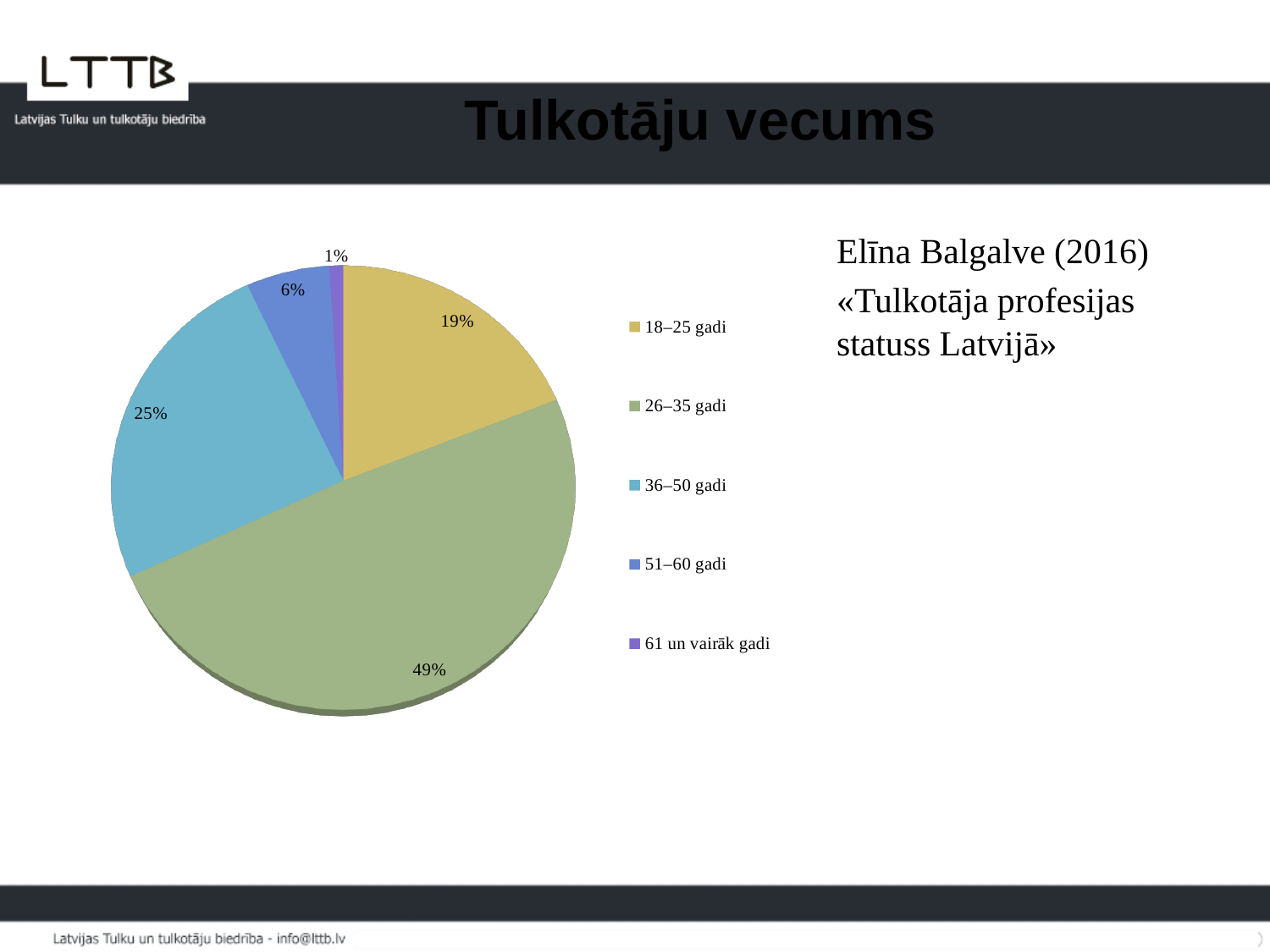
Which age group has the largest slice of the pie? 26–35 gadi What is the title of the slide containing the pie chart? Tulkotāju vecums Which is larger, the share for 18–25 gadi or the share for 36–50 gadi? 36–50 gadi What share of the pie does the 26–35 gadi slice have? 49% What kind of chart is shown on the slide? pie chart What is the value shown for 51–60 gadi? 6% Which age group has the smallest slice of the pie? 61 un vairāk gadi What is the value shown for 36–50 gadi? 25% What is the value shown for 18–25 gadi? 19% What is the difference between the shares for 26–35 gadi and 36–50 gadi? 24% What is the value shown for 61 un vairāk gadi? 1% How many age groups are shown in the pie chart? 5